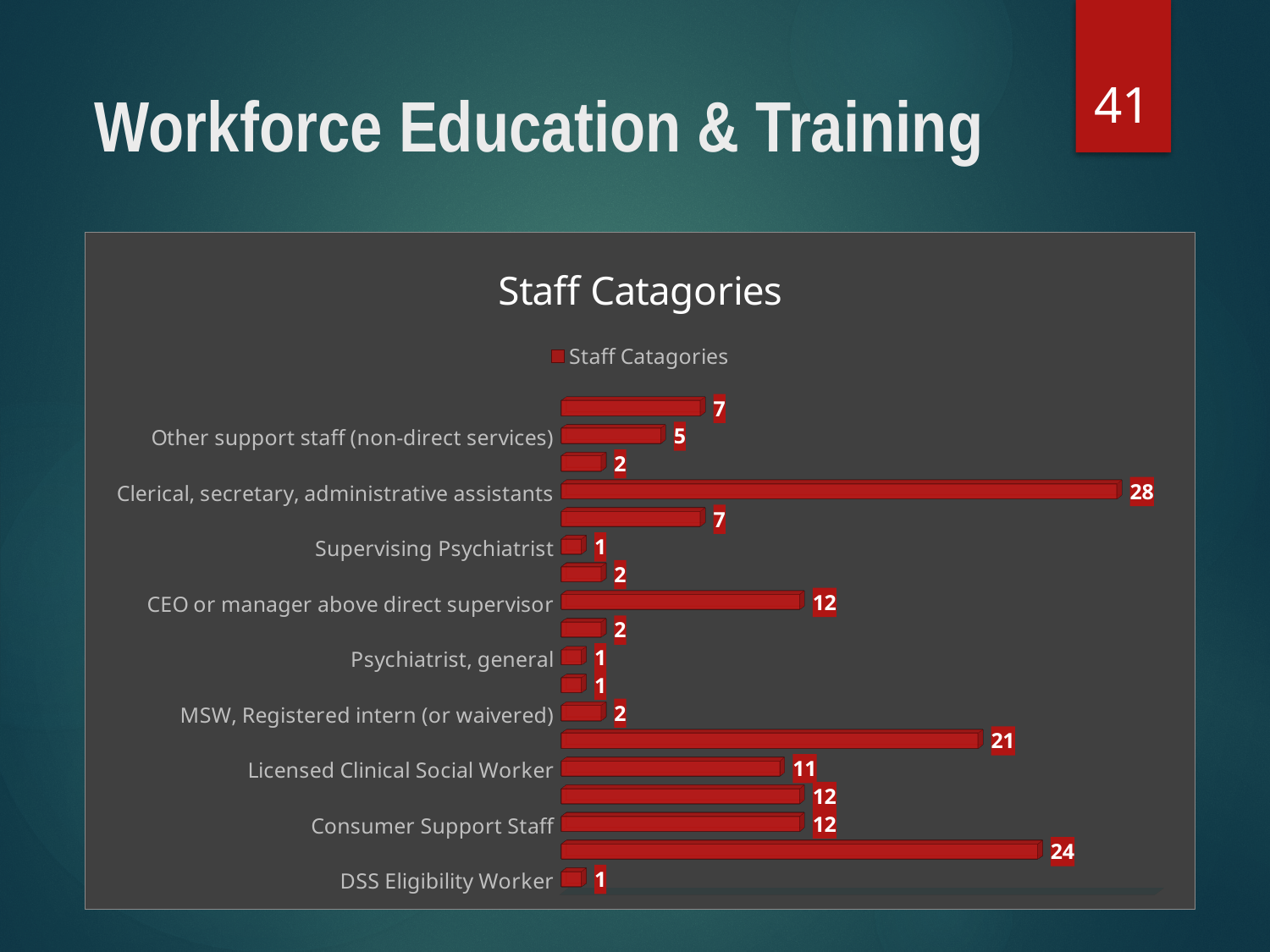
What is the value for CEO or manager above direct supervisor? 12 What is the value for DSS Eligibility Worker? 1 What is the value for Other support staff (non-direct services)? 5 How many bars are plotted in the chart? 18 Which labelled category has the highest value? Clerical, secretary, administrative assistants Which is larger, the value for Consumer Support Staff or the value for MSW, Registered intern (or waivered)? Consumer Support Staff What type of chart is shown on the slide? bar chart What is the value for Licensed Clinical Social Worker? 11 How many series does the legend list? 1 What is the value for Clerical, secretary, administrative assistants? 28 What is the difference between the values for Clerical, secretary, administrative assistants and CEO or manager above direct supervisor? 16 What is the title of the chart? Staff Catagories